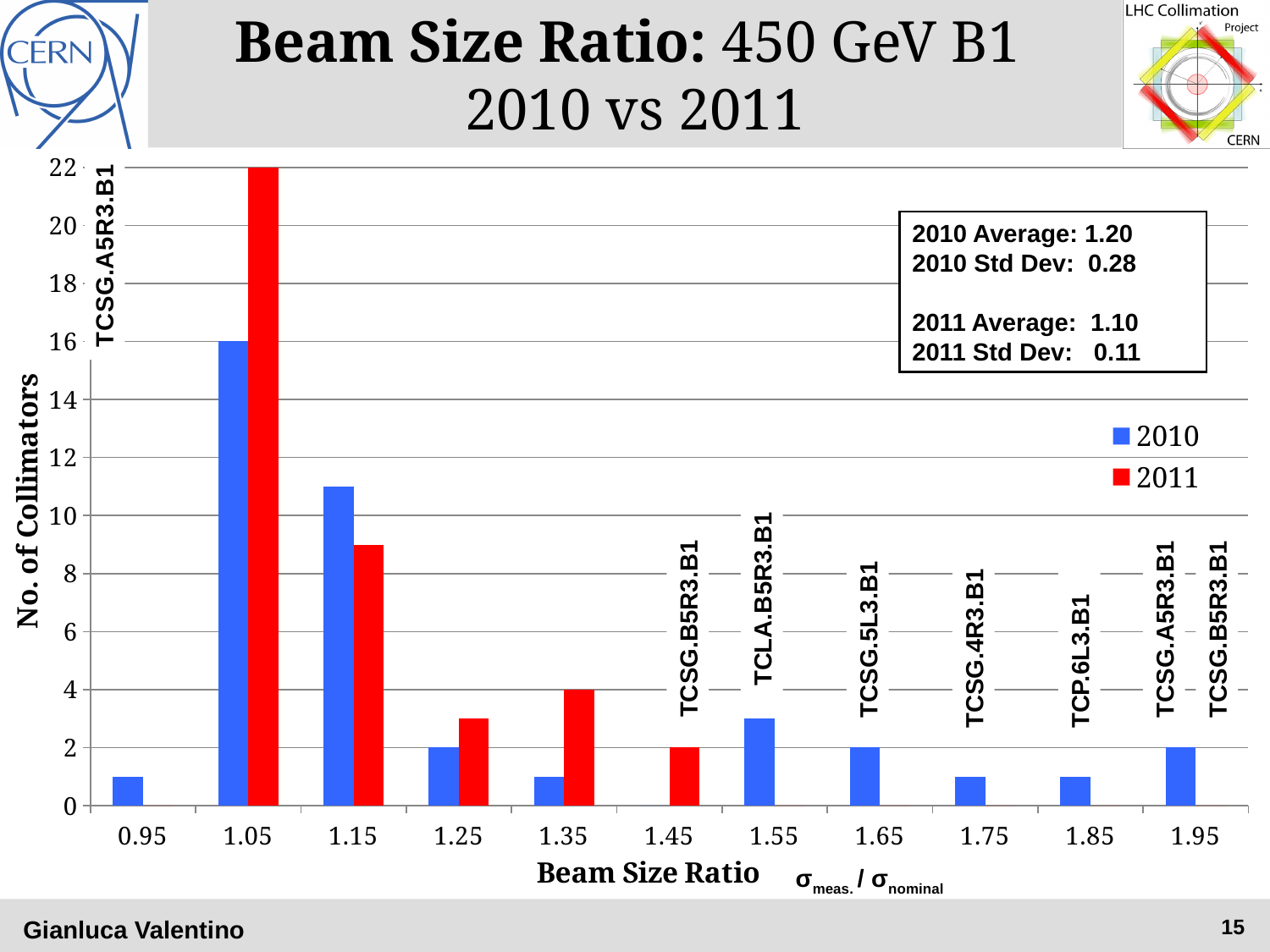
Is the 2010 value at a beam size ratio of 1.15 greater or less than 10? greater What is the number of collimators for 2011 at a beam size ratio of 1.05? 22 At a beam size ratio of 1.15, which series has the larger value, 2010 or 2011? 2010 How many beam size ratio categories are shown on the x axis? 11 Is the 2011 value at a beam size ratio of 1.15 greater or less than 10? less Which beam size ratio has the highest number of collimators for 2011? 1.05 What is the number of collimators for 2010 at a beam size ratio of 1.05? 16 According to the text box on the chart, what is the 2010 average beam size ratio? 1.20 What kind of chart is shown on the slide? bar chart What is the difference between the 2011 and 2010 values at a beam size ratio of 1.05? 6 What is the number of collimators for 2011 at a beam size ratio of 1.35? 4 How many series does the legend list? 2